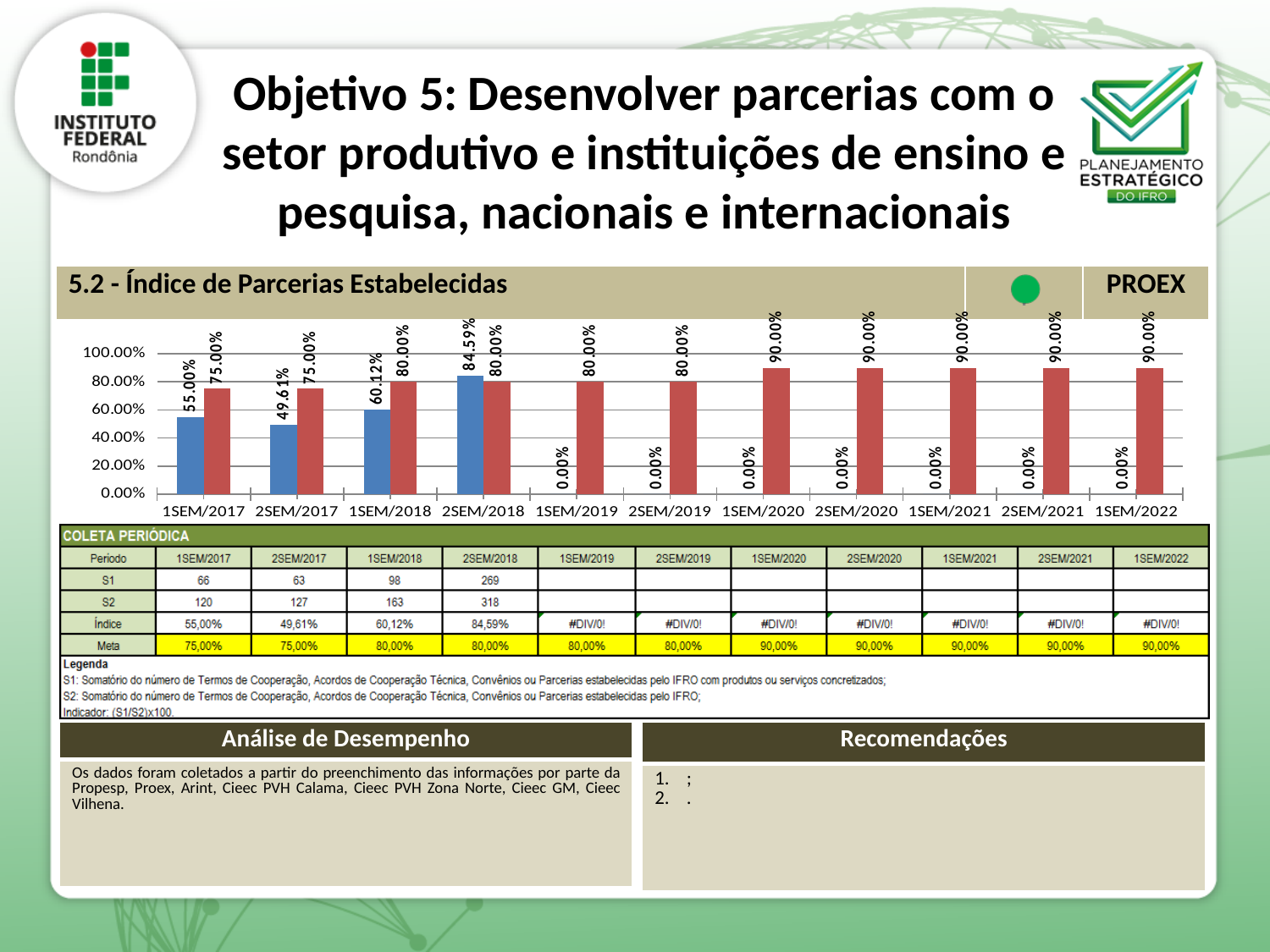
Which period has the highest blue bar? 2SEM/2018 What is the value of the blue bar for 2SEM/2018? 84.59% What kind of chart is shown on the slide? bar chart What is the value of the blue bar for 1SEM/2017? 55.00% What is the title of the chart section on the slide? 5.2 - Índice de Parcerias Estabelecidas What is the value of the red bar for 2SEM/2017? 75.00% What is the value of the red bar for 1SEM/2020? 90.00% Which is larger for 2SEM/2018, the blue bar or the red bar? the blue bar What is the difference between the red bar and the blue bar for 1SEM/2018? 19.88% Is the value of the blue bar for 2SEM/2017 greater or less than 60.00%? less Among the periods with non-zero blue bars, which period has the lowest blue bar? 2SEM/2017 How many periods (categories) are shown on the x axis of the chart? 11